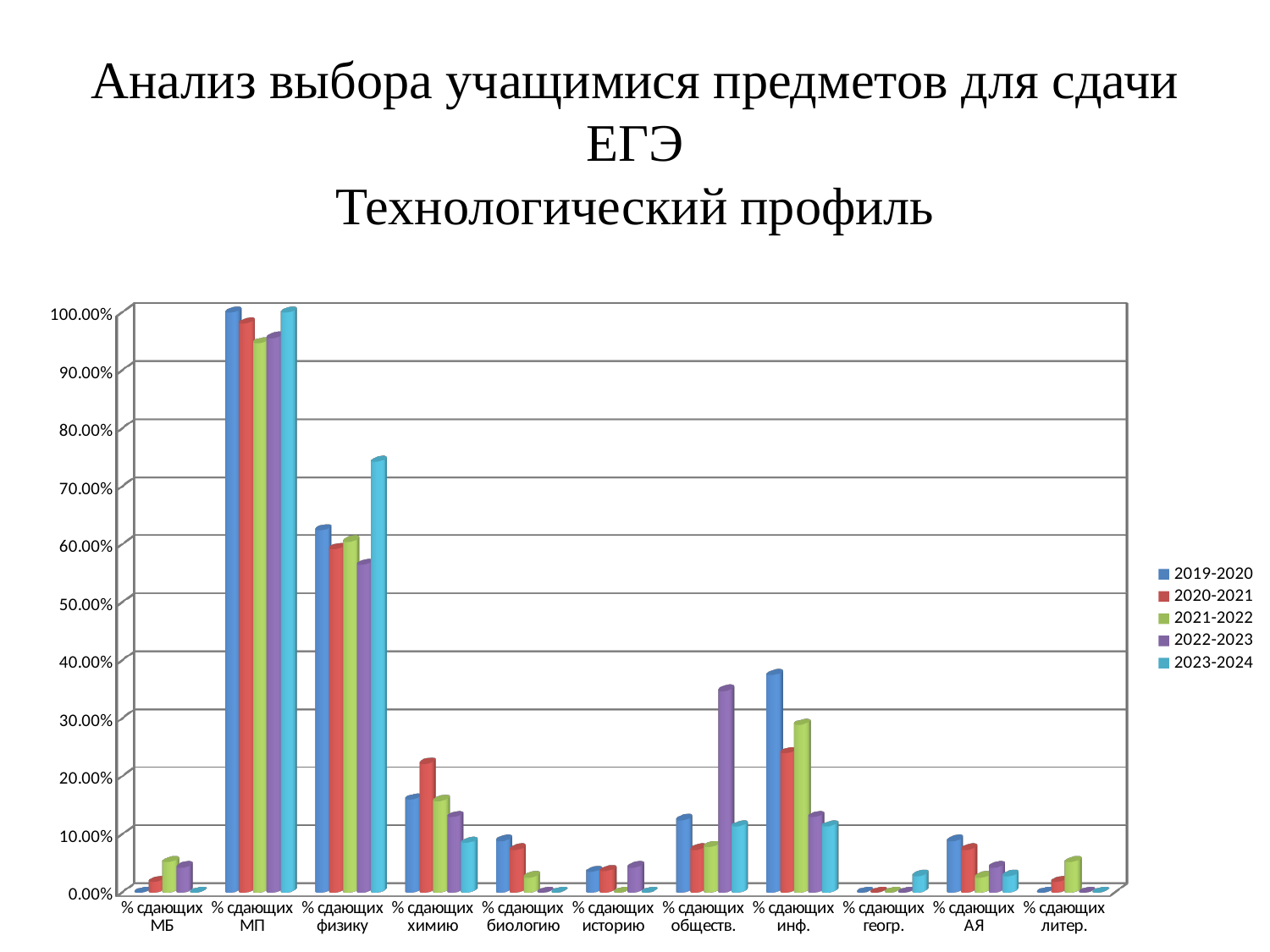
Is the value for % сдающих химию in 2020-2021 greater or less than 20.00%? greater Which series has the highest value for % сдающих физику? 2023-2024 For % сдающих обществ., which is larger: the 2019-2020 value or the 2022-2023 value? 2022-2023 Is the value for % сдающих обществ. in 2022-2023 greater or less than 30.00%? greater Which series has the lowest value for % сдающих химию? 2023-2024 How many subject categories are shown along the x axis? 11 Is the value for % сдающих физику in 2022-2023 greater or less than 60.00%? less How many series does the legend list? 5 What kind of chart is shown on the slide? bar chart Which subject category has the highest bars overall? % сдающих МП Which series has the highest value for % сдающих инф.? 2019-2020